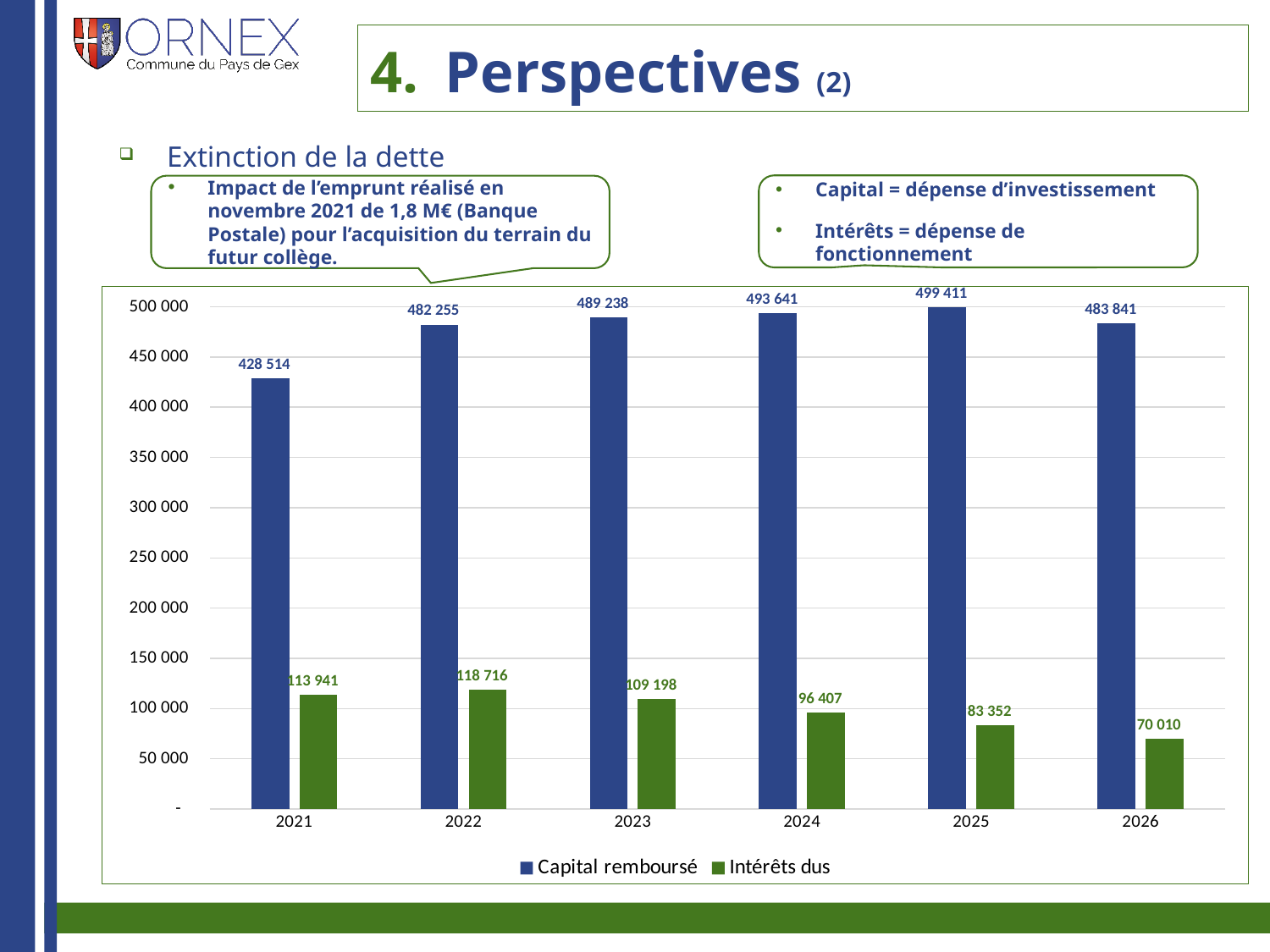
What is the combined total of Capital remboursé and Intérêts dus for 2026? 553 851 What is the value of Intérêts dus for 2024? 96 407 How many years are shown on the x axis of the chart? 6 Do the values for Intérêts dus rise or fall from 2022 to 2026? fall In which year is Intérêts dus the lowest? 2026 In which year is Intérêts dus the highest? 2022 What is the value of Capital remboursé for 2025? 499 411 Which is larger: Intérêts dus in 2023 or Intérêts dus in 2025? Intérêts dus in 2023 What is the difference between Capital remboursé and Intérêts dus in 2021? 314 573 In which year is Capital remboursé the highest? 2025 What is the value of Capital remboursé for 2021? 428 514 How many series does the legend list? 2